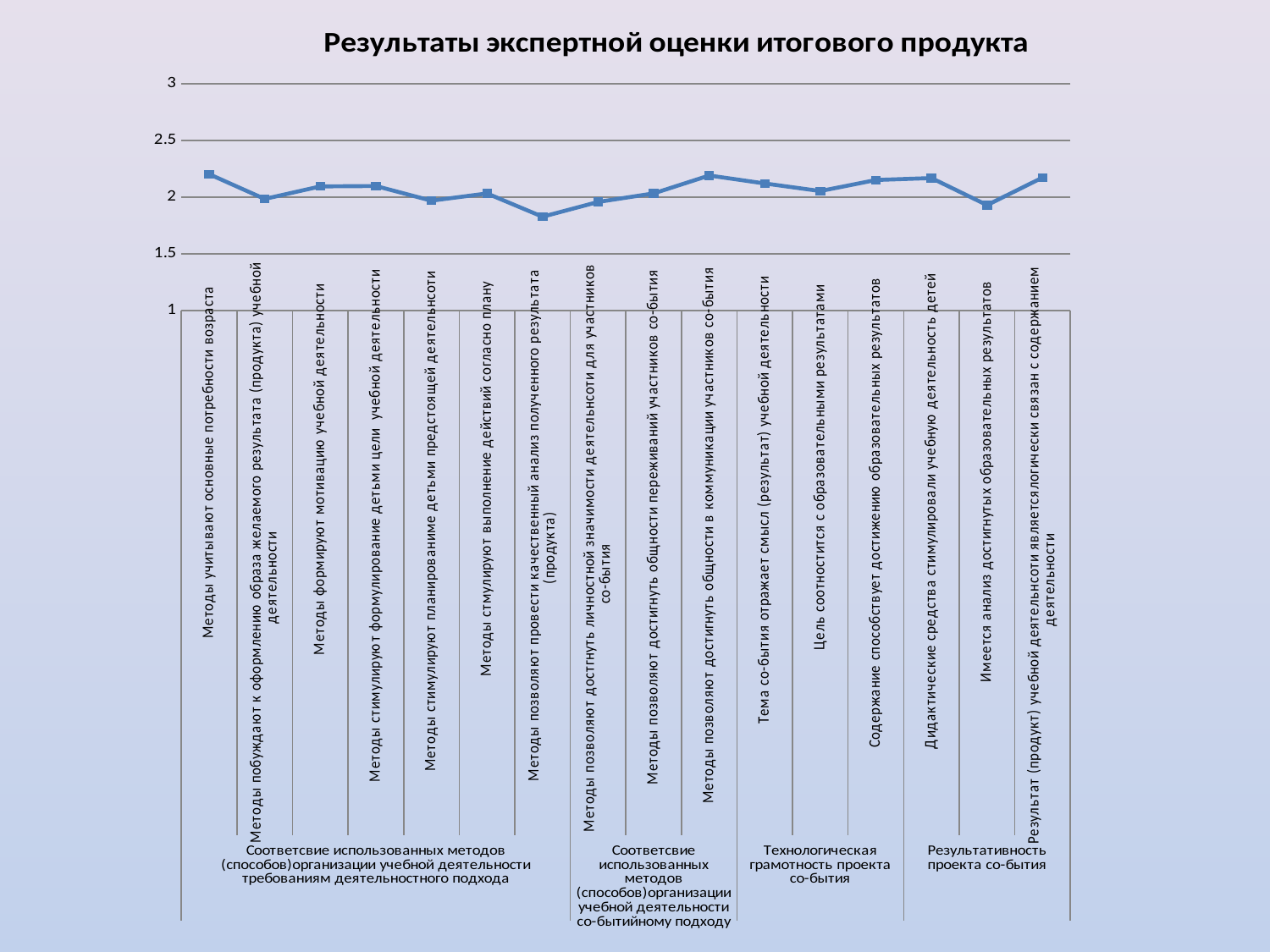
Is the value for "Имеется анализ достигнутых образовательных результатов" greater or less than 2? less Which is larger: the value for "Содержание способствует достижению образовательных результатов" or the value for "Имеется анализ достигнутых образовательных результатов"? Содержание способствует достижению образовательных результатов Is the value for "Методы учитывают основные потребности возраста" greater or less than 2? greater How many data points are plotted on the line? 16 What is the title of the chart? Результаты экспертной оценки итогового продукта Is the value for "Методы позволяют достигнуть общности в коммуникации участников со-бытия" greater or less than 2? greater How many category groups are labelled along the bottom of the chart? 4 Which is larger: the value for "Методы учитывают основные потребности возраста" or the value for "Методы позволяют провести качественный анализ полученного результата (продукта)"? Методы учитывают основные потребности возраста What kind of chart is shown on the slide? line chart Which category has the lowest value? Методы позволяют провести качественный анализ полученного результата (продукта)